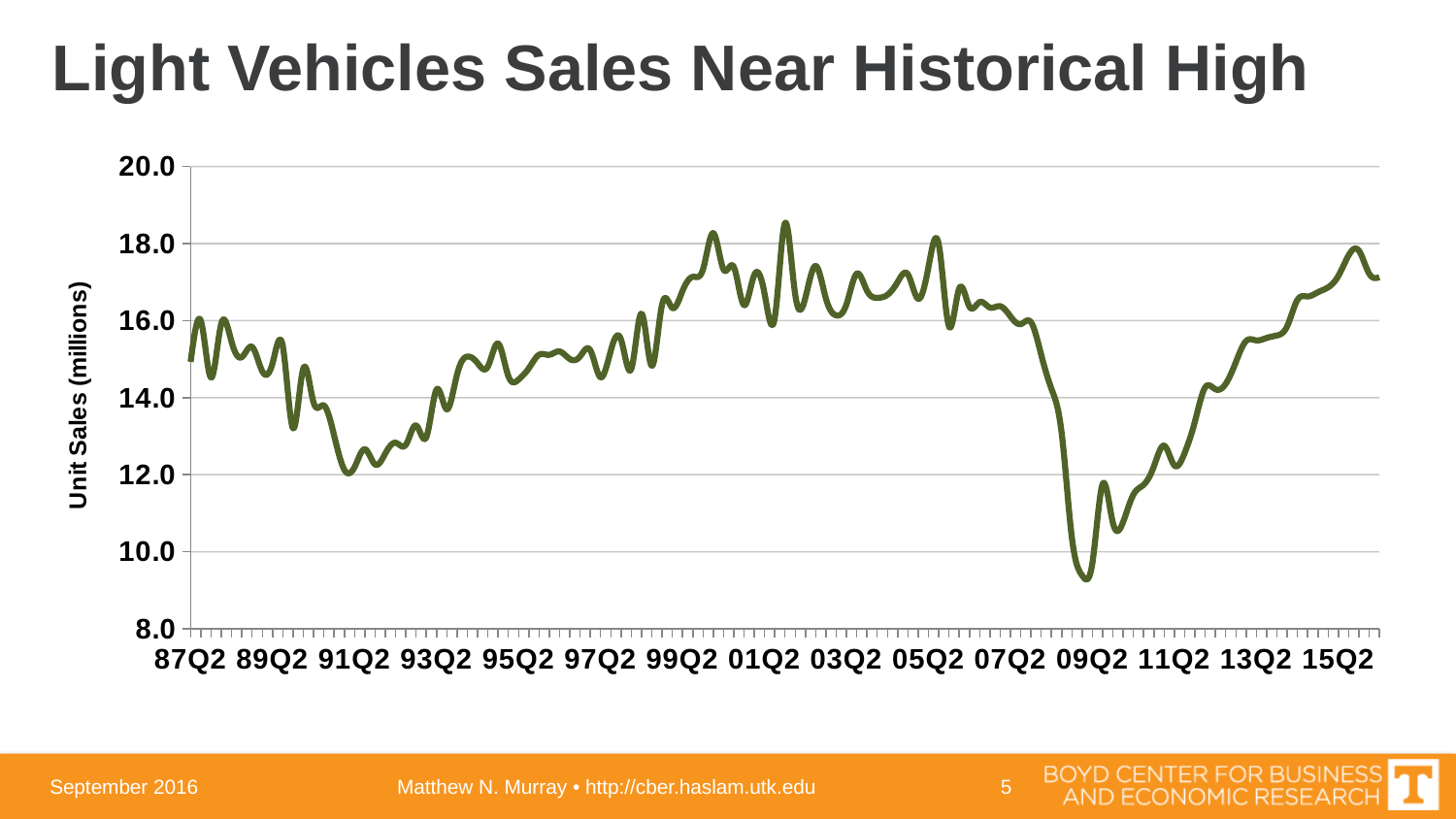
How many labels are shown along the x axis of the chart? 15 Is the value at 11Q2 greater or less than 14.0? less What kind of chart is shown on the slide? line chart What is the title of the chart? Light Vehicles Sales Near Historical High Do the values rise or fall between 09Q2 and 15Q2? rise Is the value at 09Q2 greater or less than 10.0? less What is the label on the vertical axis of the chart? Unit Sales (millions) Is the value at 15Q2 greater or less than 16.0? greater Near which x-axis label does the line reach its lowest point? 09Q2 Which is larger, the value at 09Q2 or the value at 15Q2? 15Q2